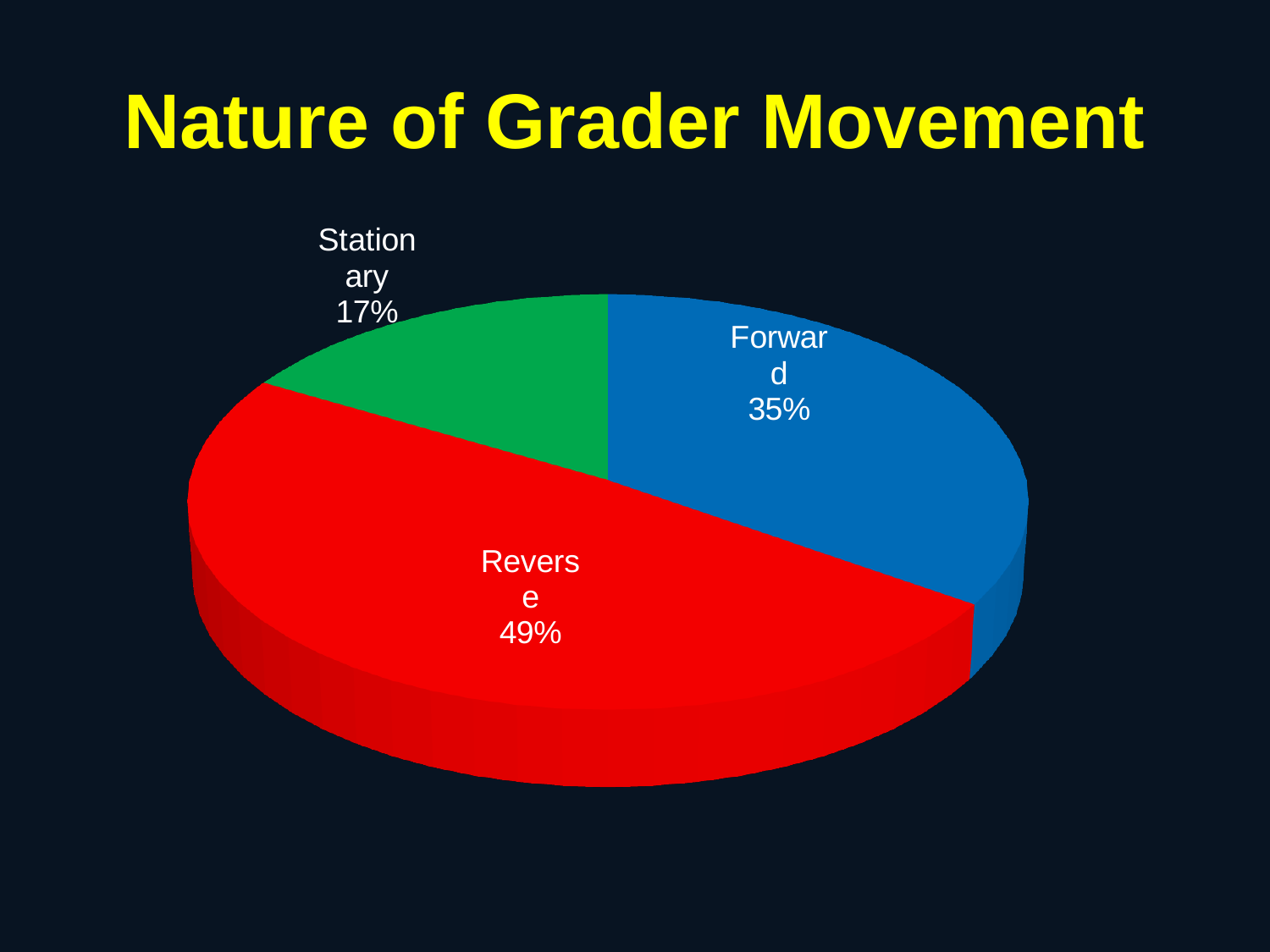
Which is larger, the share for Forward or the share for Stationary? Forward What percentage of the pie is Stationary? 17% What is the difference in percentage points between Reverse and Forward? 14 What percentage of the pie is Reverse? 49% What colour is the Reverse slice? red What kind of chart is shown on the slide? pie chart What percentage of the pie is Forward? 35% Which category has the smallest share of the pie? Stationary Which category has the largest share of the pie? Reverse How many slices does the pie chart have? 3 What is the title of the chart? Nature of Grader Movement What is the difference in percentage points between Forward and Stationary? 18